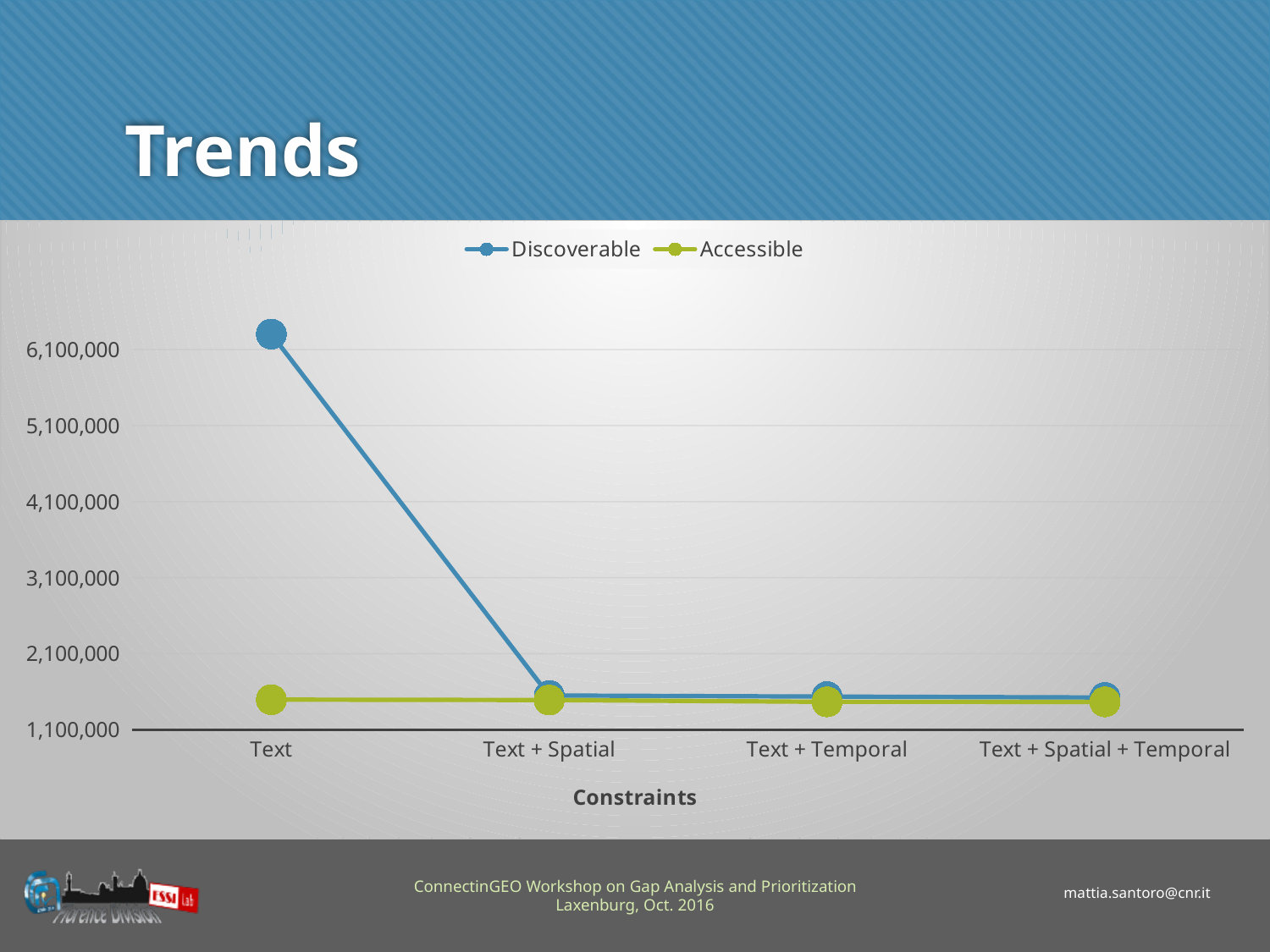
For which constraint is the Discoverable value highest? Text Is the Discoverable value for Text greater or less than 6,100,000? greater Which is larger for the Text constraint, Discoverable or Accessible? Discoverable What kind of chart is shown on the slide? line chart Which series is drawn in green? Accessible Does the Discoverable series rise or fall from Text to Text + Spatial? fall What is the title of the x axis? Constraints Is the Discoverable value for Text + Spatial greater or less than 3,100,000? less How many series does the legend list? 2 Is the Accessible value for Text greater or less than 2,100,000? less How many categories are shown on the x axis? 4